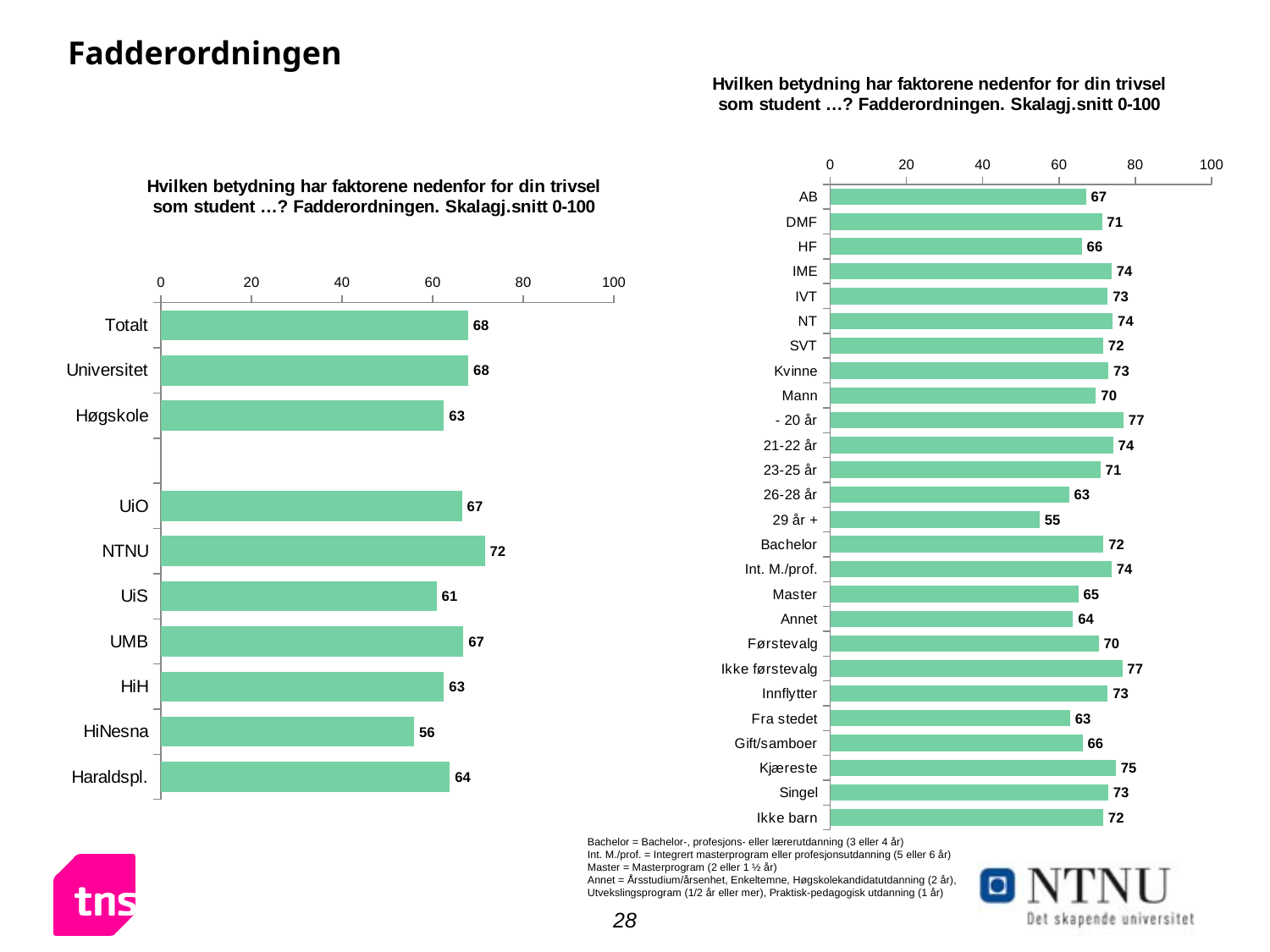
In the right chart, which is larger, the value for Innflytter or the value for Fra stedet? Innflytter In the right chart, which category has the lowest value? 29 år + In the left chart, what is the value for NTNU? 72 In the left chart, how many categories are plotted? 10 In the right chart, what is the value for Kjæreste? 75 In the left chart, which is larger, the value for Universitet or the value for Høgskole? Universitet In the left chart, what is the difference between the values for NTNU and UiS? 11 In the left chart, which category has the highest value? NTNU What kind of chart is the left chart? Bar chart In the left chart, which category has the lowest value? HiNesna In the right chart, how many categories are plotted? 26 In the right chart, what is the difference between the values for Ikke førstevalg and Førstevalg? 7